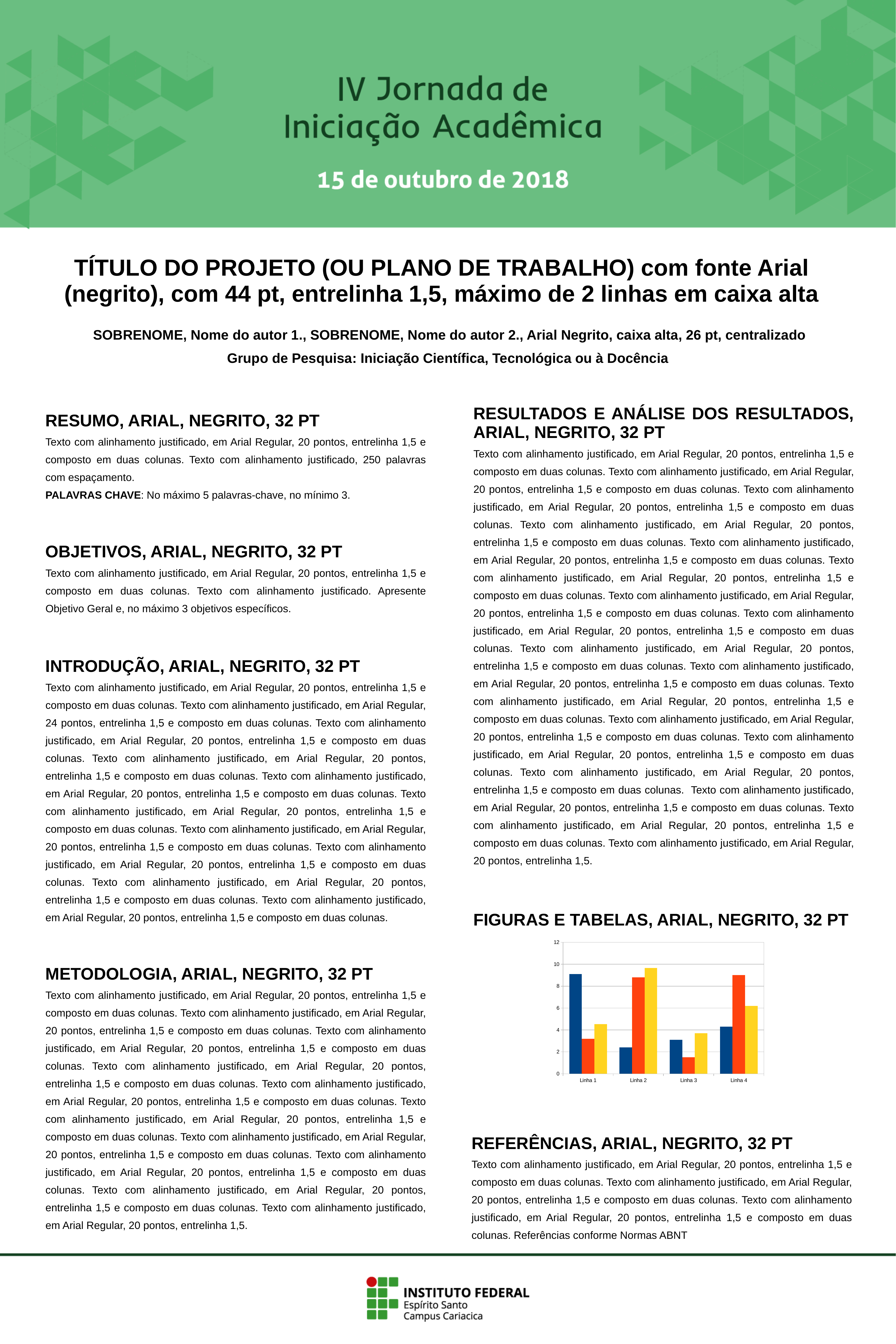
What kind of chart is shown under the heading "FIGURAS E TABELAS"? bar chart For Linha 1, which is larger: the blue bar or the red bar? the blue bar Is the value of the red bar for Linha 3 greater or less than 2? less How many bars are plotted for each category in the bar chart? 3 Is the value of the yellow bar for Linha 4 greater or less than 4? greater What are the category labels on the x axis of the bar chart? Linha 1, Linha 2, Linha 3, Linha 4 How many categories are shown on the x axis of the bar chart? 4 Is the value of the yellow bar for Linha 2 greater or less than 8? greater Which category has the shortest red bar? Linha 3 Which category has the tallest blue bar? Linha 1